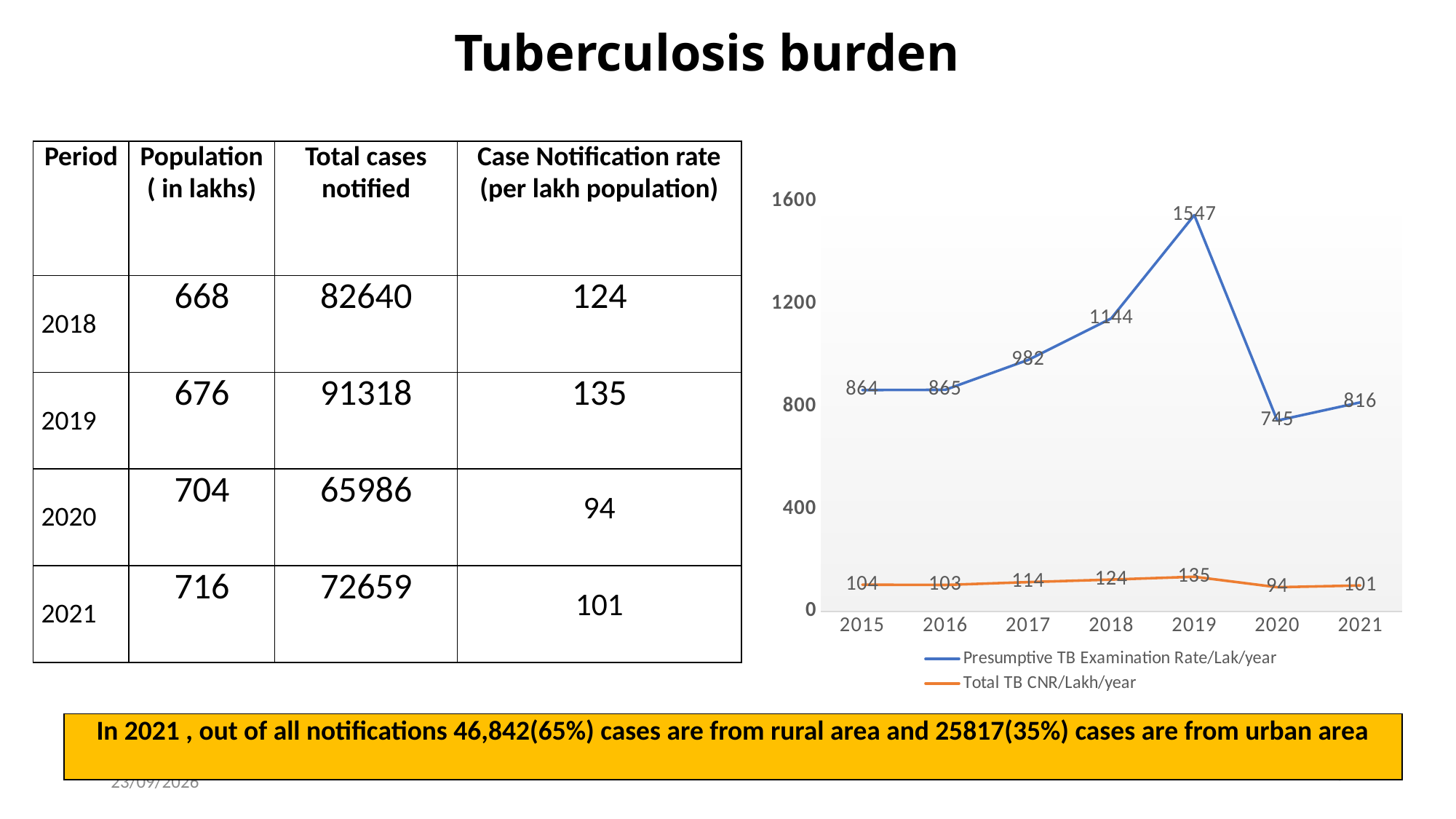
Is the Presumptive TB Examination Rate/Lak/year for 2018 greater or less than 1200? less What is the Presumptive TB Examination Rate/Lak/year value for 2019? 1547 How many years are plotted on the x axis of the chart? 7 In which year is the Presumptive TB Examination Rate/Lak/year highest? 2019 In which year is the Total TB CNR/Lakh/year highest? 2019 What is the Total TB CNR/Lakh/year value for 2020? 94 In which year is the Presumptive TB Examination Rate/Lak/year lowest? 2020 How many series does the chart legend list? 2 What is the Presumptive TB Examination Rate/Lak/year value for 2017? 982 What type of chart is shown on the slide? line chart Which series is drawn in orange in the chart? Total TB CNR/Lakh/year What is the difference between the Presumptive TB Examination Rate/Lak/year in 2019 and 2020? 802